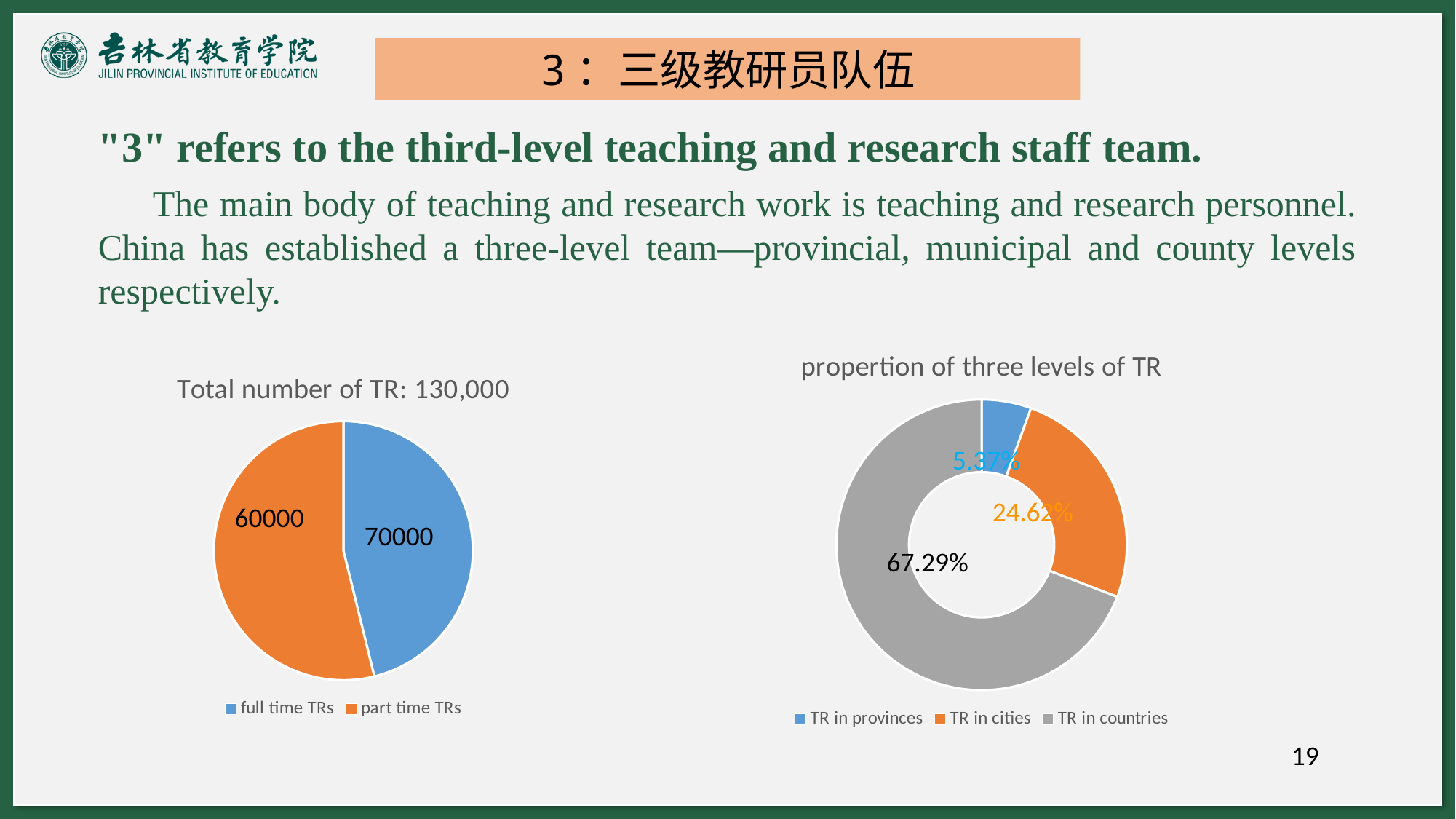
In the chart titled "Total number of TR: 130,000", what is the value for full time TRs? 70000 In the chart titled "Total number of TR: 130,000", which category has the larger value? full time TRs In the chart titled "proportion of three levels of TR", what is the share for TR in cities? 24.62% What kind of chart is the one titled "Total number of TR: 130,000"? pie chart In the chart titled "proportion of three levels of TR", what is the share for TR in provinces? 5.37% In the chart titled "proportion of three levels of TR", what is the share for TR in countries? 67.29% In the chart titled "proportion of three levels of TR", how many categories does the legend list? 3 In the chart titled "Total number of TR: 130,000", what is the difference between full time TRs and part time TRs? 10000 In the chart titled "proportion of three levels of TR", which category has the smallest share? TR in provinces In the chart titled "Total number of TR: 130,000", what is the value for part time TRs? 60000 In the chart titled "Total number of TR: 130,000", how many categories does the legend list? 2 In the chart titled "proportion of three levels of TR", which colour represents TR in countries? grey